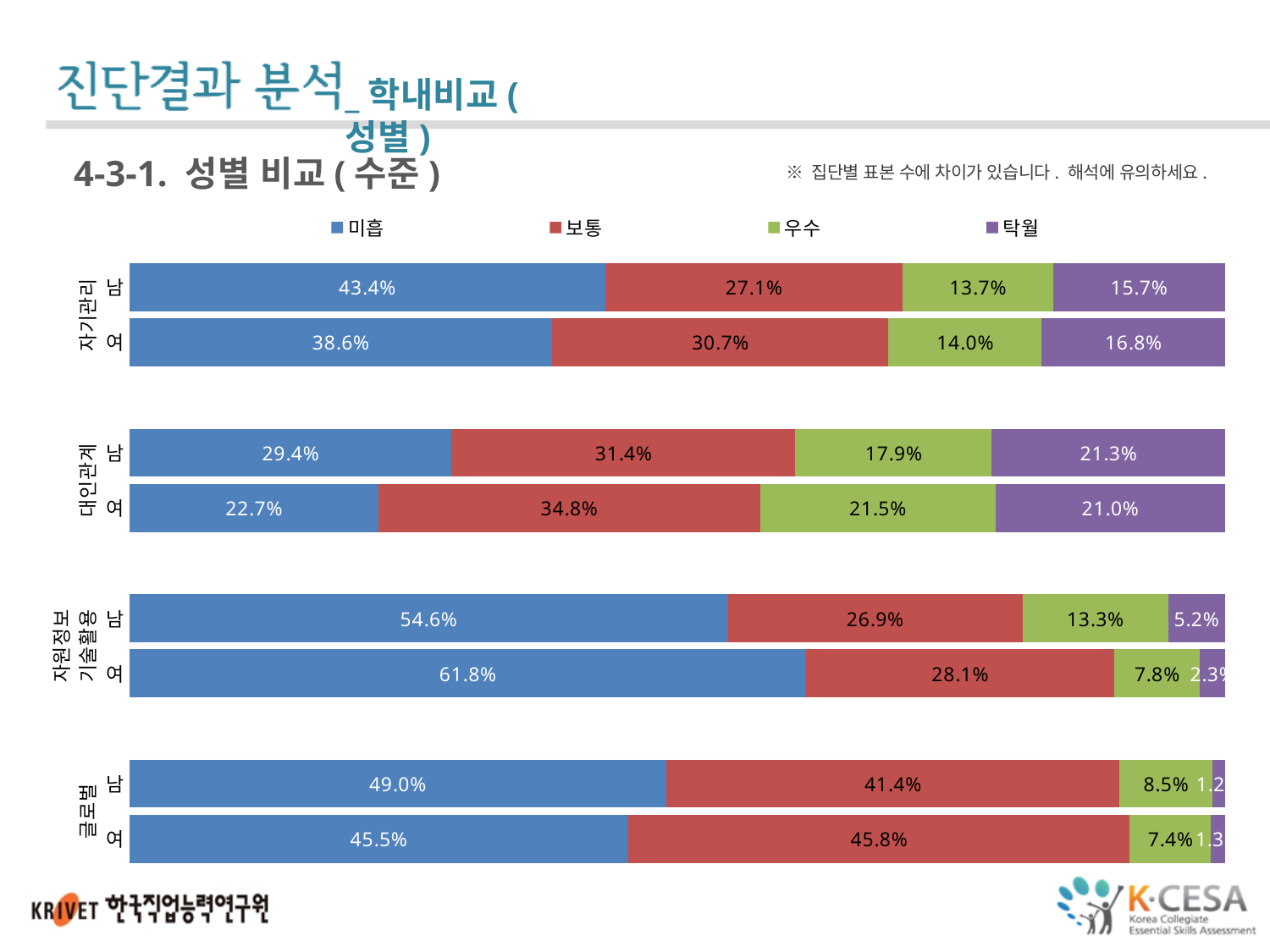
What is the difference between the 미흡 values for 자원정보기술활용 여 and 자원정보기술활용 남? 7.2% What kind of chart is shown on the slide? stacked bar chart How many series does the legend list? 4 What is the 보통 value for 글로벌 여? 45.8% What is the 보통 value for 자기관리 여? 30.7% Which bar has the highest 미흡 value? 자원정보기술활용 여 What is the total of the 미흡 and 보통 values for 글로벌 남? 90.4% What is the 미흡 value for 자기관리 남? 43.4% Which is larger, the 우수 value for 대인관계 여 or for 대인관계 남? 대인관계 여 What is the 탁월 value for 대인관계 남? 21.3% Which bar has the lowest 미흡 value? 대인관계 여 What is the 우수 value for 자원정보기술활용 여? 7.8%